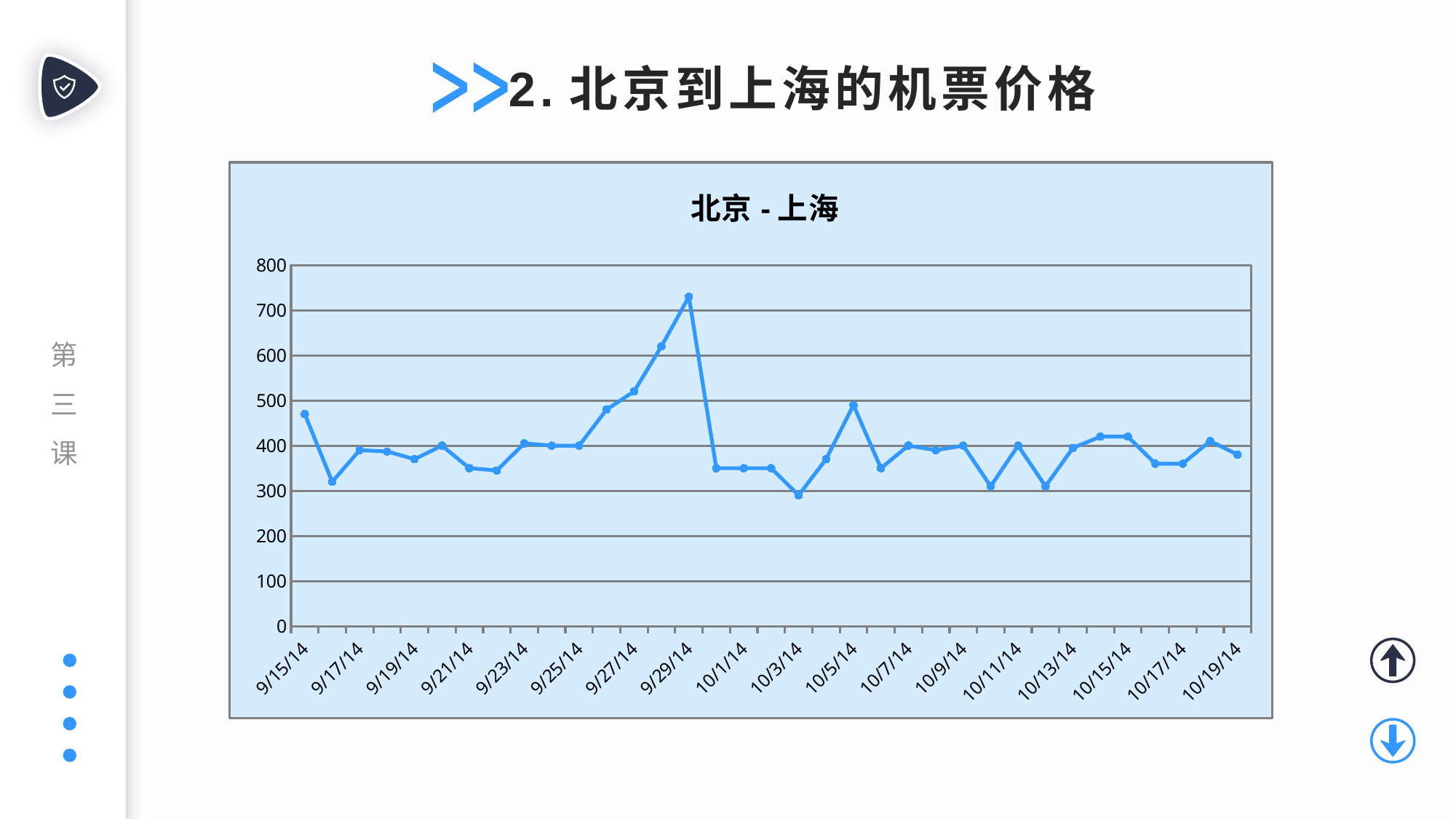
Which is larger, the value for 9/29/14 or the value for 9/15/14? 9/29/14 What is the highest value shown on the vertical axis? 800 Is the value for 9/15/14 greater or less than 400? greater Does the line rise or fall between 9/25/14 and 9/29/14? rise Which is larger, the value for 10/5/14 or the value for 10/3/14? 10/5/14 Is the value for 10/5/14 greater or less than 400? greater On which date does the line reach its highest value? 9/29/14 Is the value for 9/29/14 greater or less than 700? greater What kind of chart is shown on the slide? line chart What is the title of the chart? 北京 - 上海